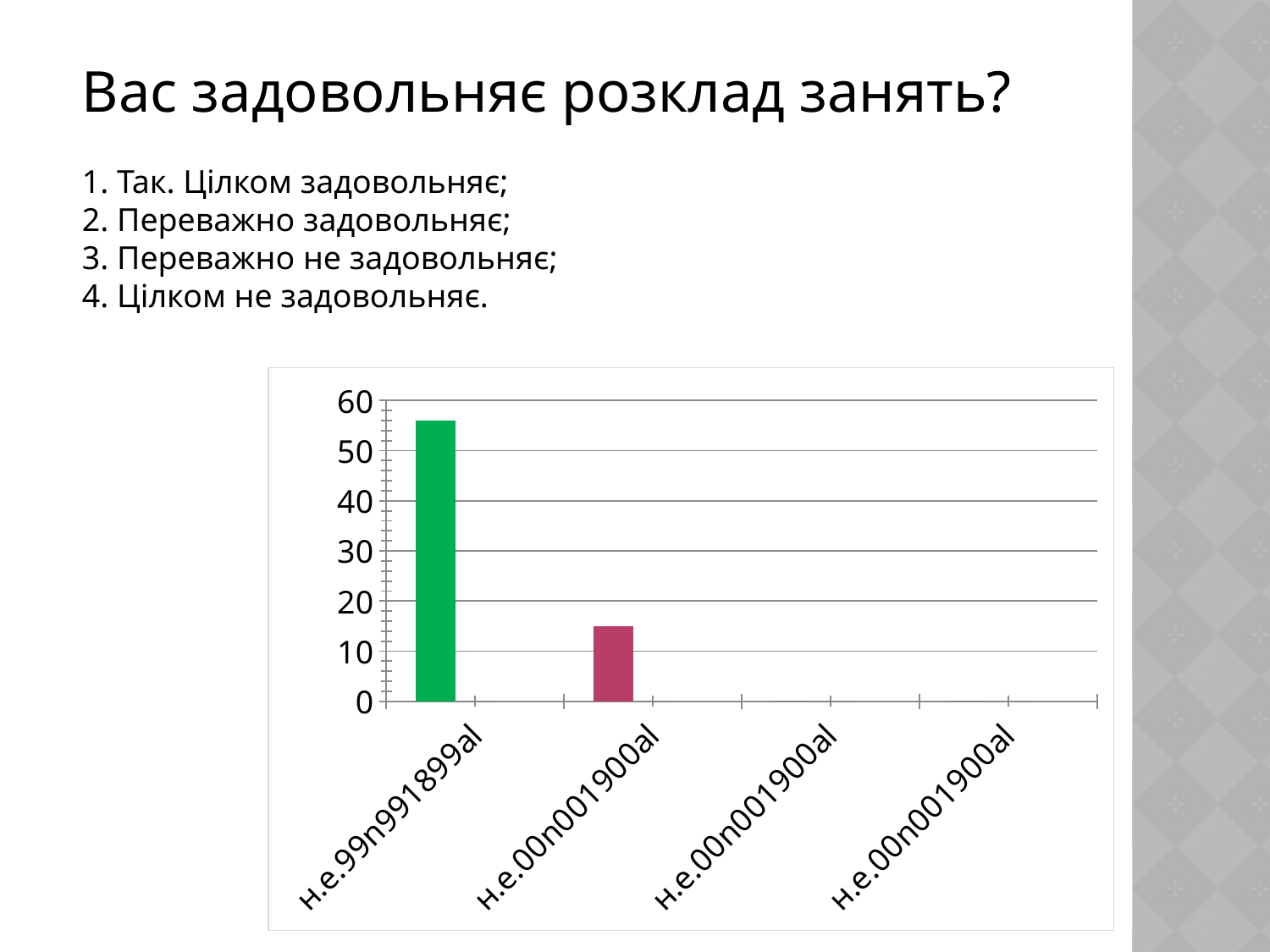
How many categories in the chart show no visible bar? 2 Which is larger, the first bar or the second bar? the first bar What is the highest value shown on the vertical axis of the chart? 60 Is the value of the second bar greater or less than 10? greater What kind of chart is shown on the slide? bar chart Do the bar values rise or fall from left to right along the x axis? fall What colour is the tallest bar in the chart? green Is the value of the first bar (н.е.99n991899al) greater or less than 60? less Is the value of the first bar (н.е.99n991899al) greater or less than 50? greater Which category has the tallest bar in the chart? the first category (н.е.99n991899al) How many categories are shown on the x axis of the chart? 4